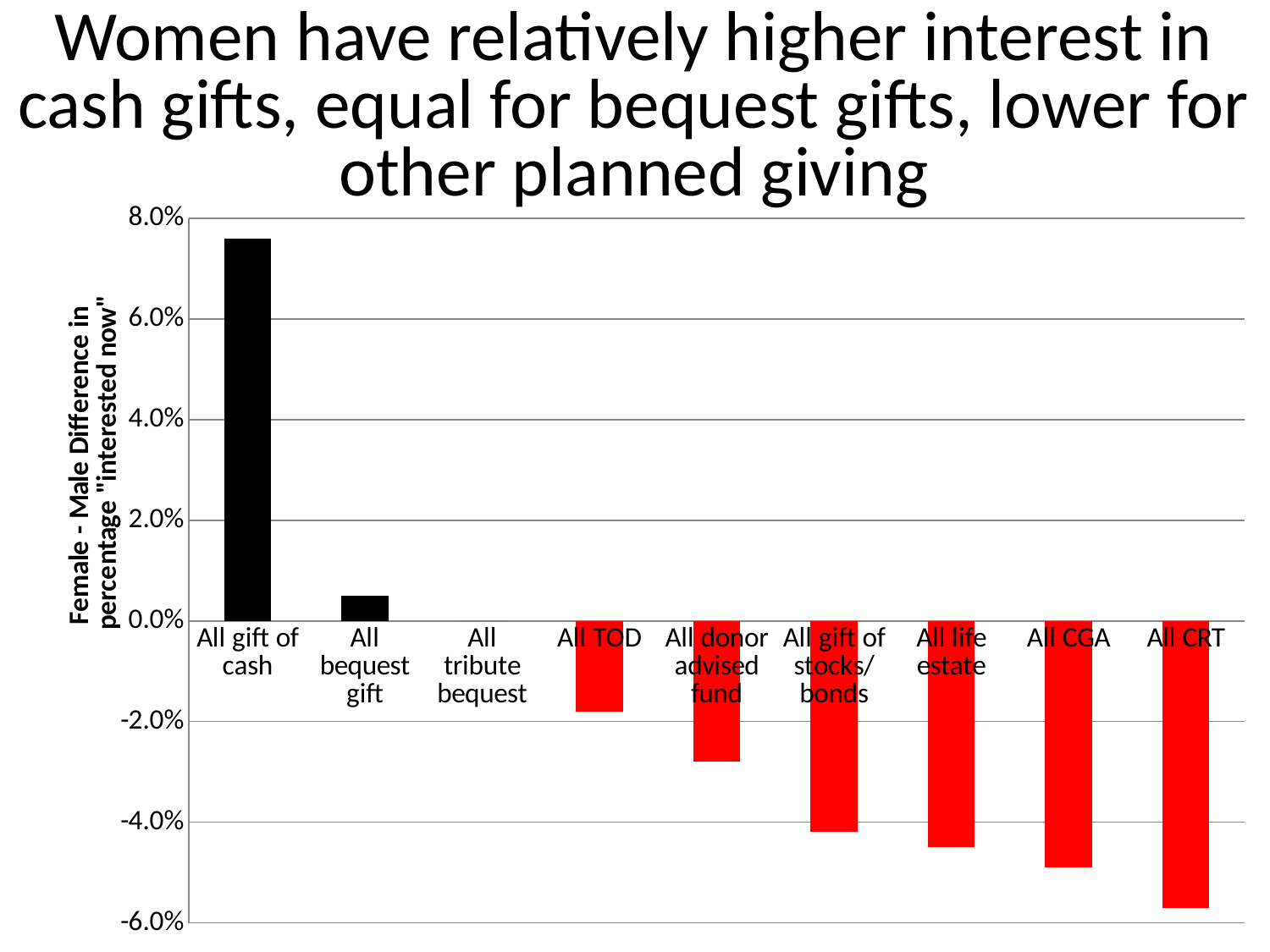
Is the value for All CRT greater or less than -4.0%? less What kind of chart is shown on the slide? Bar chart Which category has the highest value? All gift of cash Is the value for All TOD greater or less than -2.0%? greater Is the value for All gift of cash greater or less than 6.0%? greater What colour are the bars with negative values? Red How many categories are plotted on the chart? 9 Which category has the lowest value? All CRT Which is larger, the value for All bequest gift or the value for All life estate? All bequest gift Do the values generally rise or fall moving from left to right across the categories? Fall What is the label on the vertical axis? Female - Male Difference in percentage "interested now"